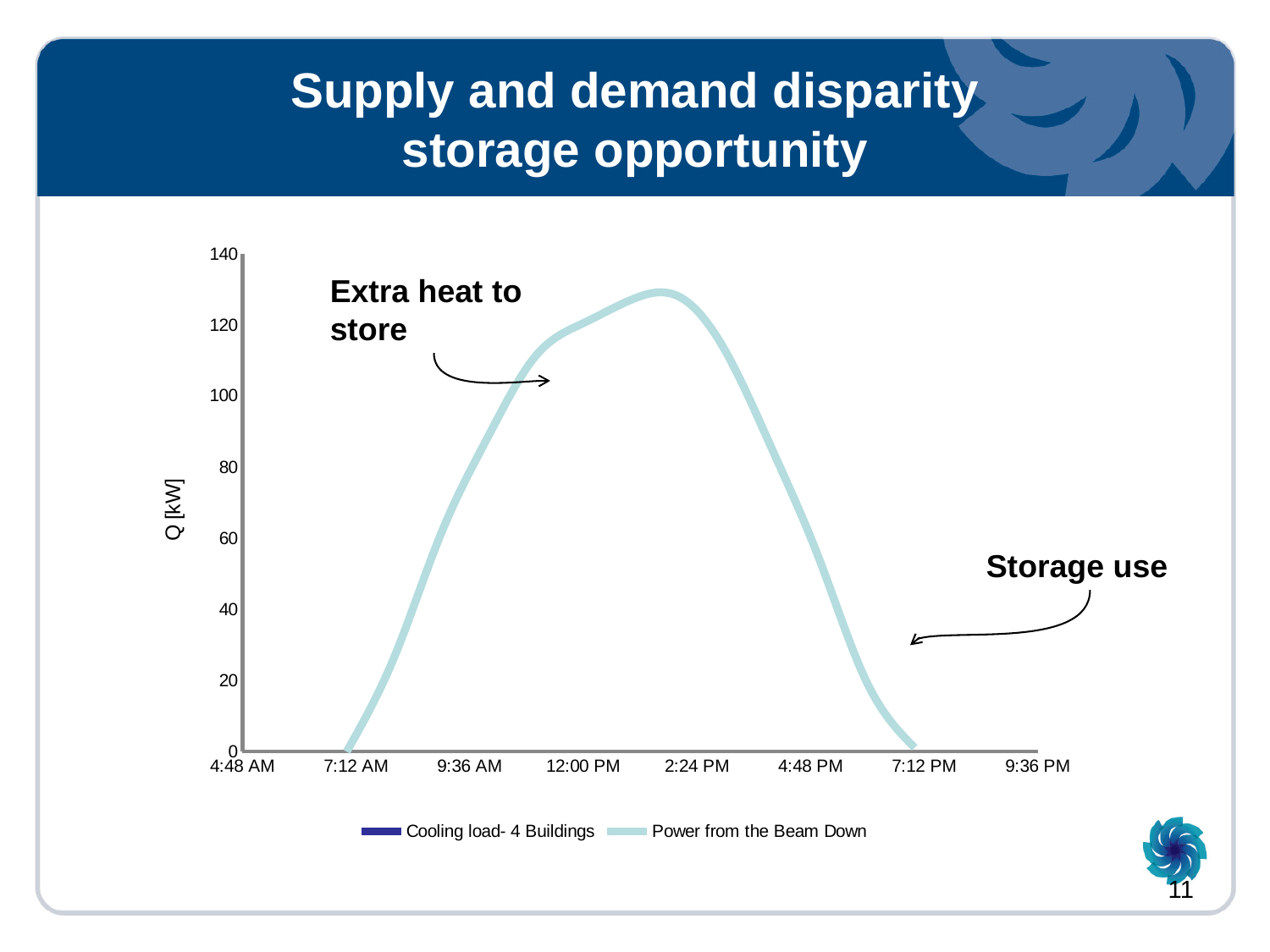
Does the Power from the Beam Down curve rise or fall between 2:24 PM and 7:12 PM? fall Is the value of the Power from the Beam Down curve at 12:00 PM greater or less than 100? greater How many series does the legend list? 2 Is the value of the Power from the Beam Down curve at 9:36 AM greater or less than 60? greater What is the value of the Power from the Beam Down curve at 7:12 AM? 0 Is the value of the Power from the Beam Down curve at 2:24 PM greater or less than 100? greater Which series is drawn in light blue according to the legend? Power from the Beam Down What kind of chart is shown on the slide? line chart Does the Power from the Beam Down curve rise or fall between 7:12 AM and 12:00 PM? rise What is the label of the y axis? Q [kW]